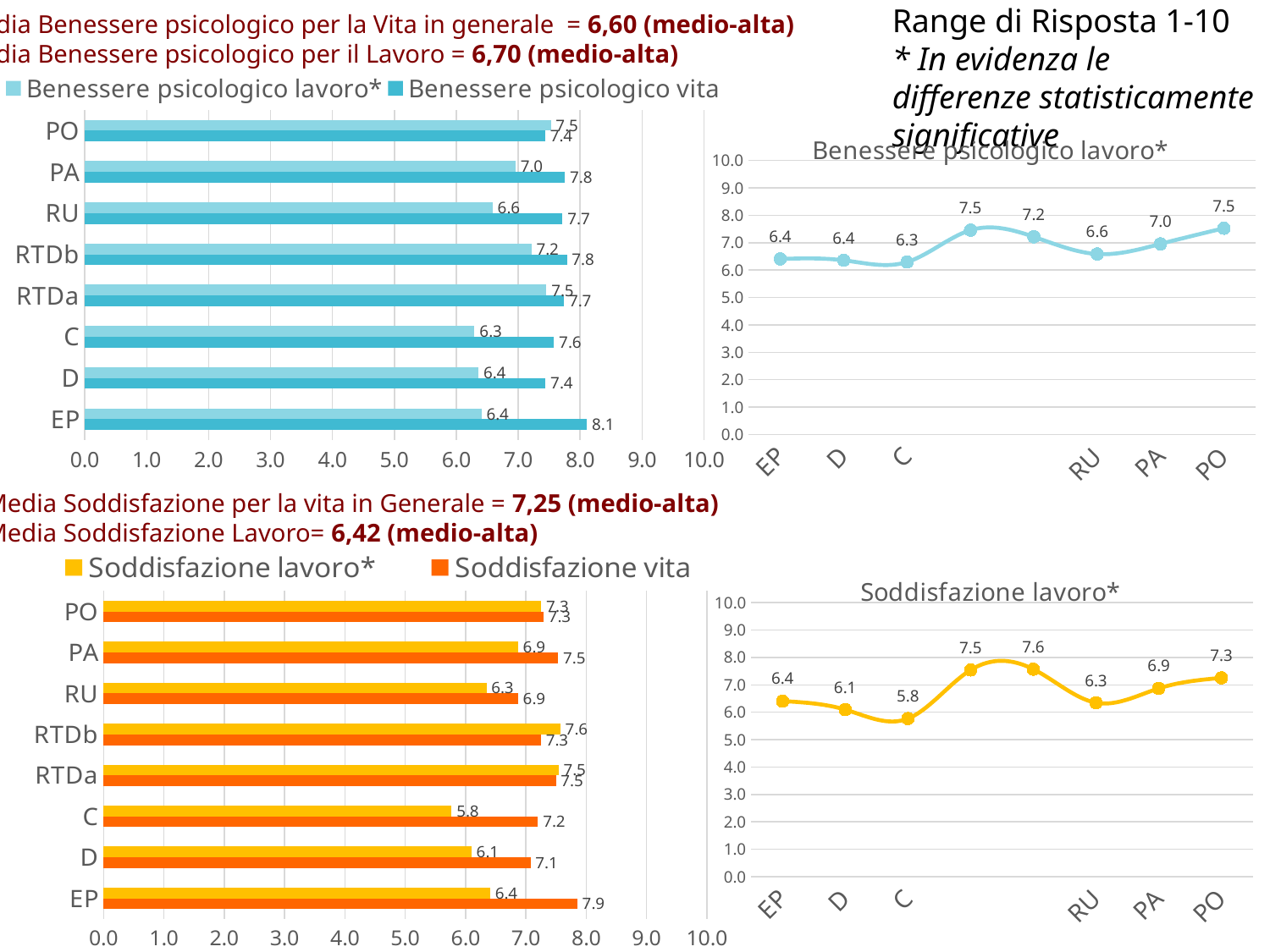
In the bottom-left bar chart, which is larger for RTDb: Soddisfazione lavoro* or Soddisfazione vita? Soddisfazione lavoro* In the bottom-left bar chart, what is the value of Soddisfazione vita for EP? 7.9 In the line chart titled 'Benessere psicologico lavoro*', what is the value for C? 6.3 In the top-left bar chart, what is the value of Benessere psicologico vita for EP? 8.1 In the top-left bar chart, which category has the highest value for Benessere psicologico vita? EP In the top-left bar chart, how many categories are shown on the vertical axis? 8 In the bottom-left bar chart, which category has the lowest value for Soddisfazione lavoro*? C In the line chart titled 'Soddisfazione lavoro*', what is the value for PA? 6.9 What type of chart is the chart titled 'Soddisfazione lavoro*' on the bottom right? Line chart In the line chart titled 'Benessere psicologico lavoro*', which labelled category has the lowest value? C In the top-left bar chart, what is the difference between Benessere psicologico vita and Benessere psicologico lavoro* for PA? 0.8 In the top-left bar chart, what is the value of Benessere psicologico lavoro* for RU? 6.6